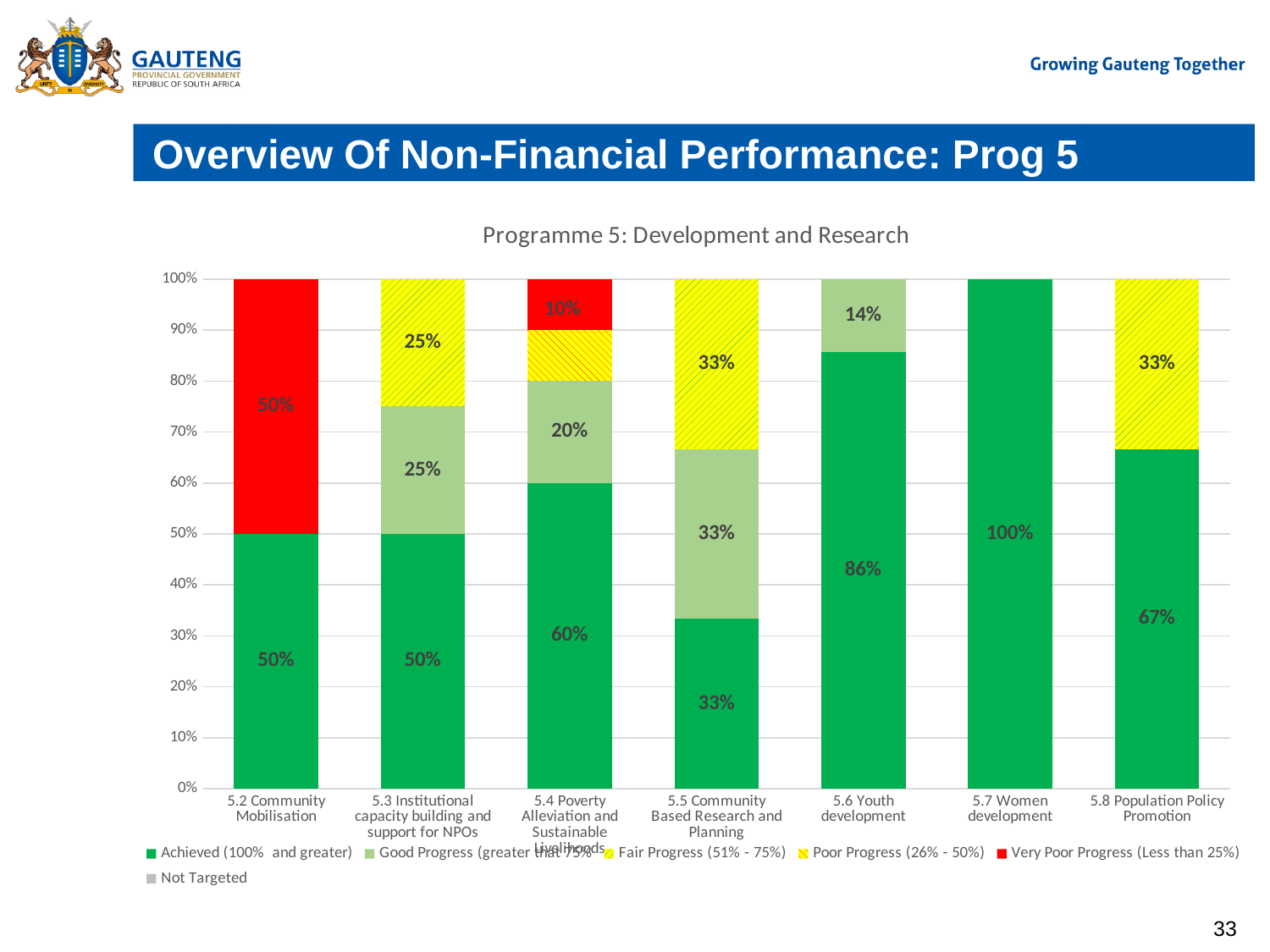
How many series does the legend list? 6 What is the title of the chart? Programme 5: Development and Research What is the Fair Progress (51% - 75%) value for 5.8 Population Policy Promotion? 33% What type of chart is shown on the slide? Stacked bar chart Which has a larger Achieved (100% and greater) share: 5.6 Youth development or 5.8 Population Policy Promotion? 5.6 Youth development How many categories (sub-programmes) are shown on the x axis? 7 What is the Very Poor Progress (Less than 25%) value for 5.2 Community Mobilisation? 50% Which category has the highest Achieved (100% and greater) share? 5.7 Women development Which category has the lowest Achieved (100% and greater) share? 5.5 Community Based Research and Planning What is the Achieved (100% and greater) value for 5.6 Youth development? 86% What is the Good Progress (greater that 75%) value for 5.4 Poverty Alleviation and Sustainable Livelihoods? 20% What is the difference between the Achieved (100% and greater) share for 5.6 Youth development and for 5.8 Population Policy Promotion? 19 percentage points